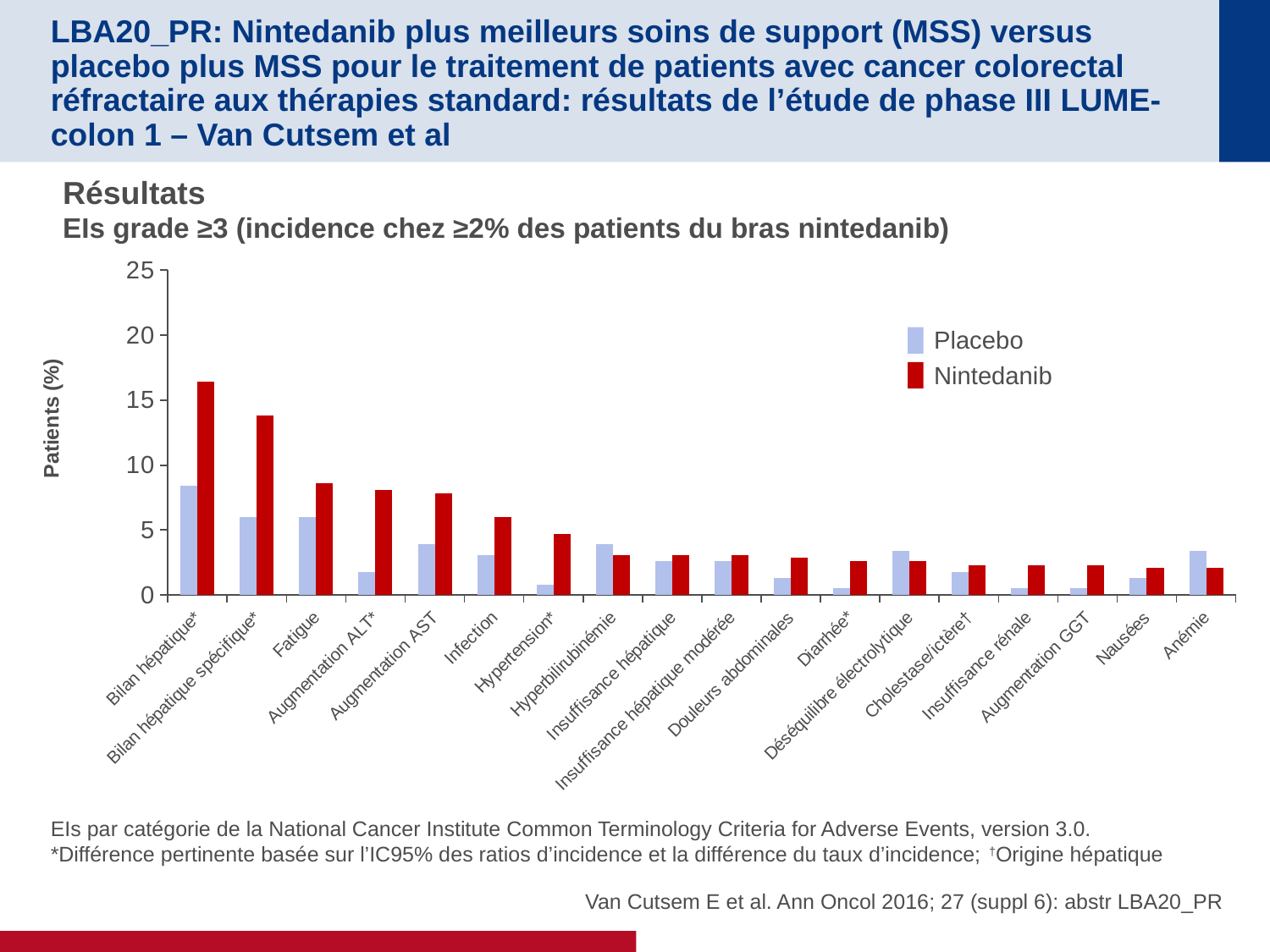
Which category has the highest value for Placebo? Bilan hépatique* Is the Nintedanib value for Augmentation ALT* greater or less than 5? greater How many adverse event categories are shown on the x axis? 18 What kind of chart is shown on the slide? bar chart Which category has the highest value for Nintedanib? Bilan hépatique* Is the Placebo value for Hypertension* greater or less than 5? less Do the Nintedanib values generally rise or fall from left to right along the x axis? fall Is the Nintedanib value for Bilan hépatique* greater or less than 15? greater How many series does the legend list? 2 What is the label of the y axis? Patients (%) For Anémie, which series has the larger value, Placebo or Nintedanib? Placebo